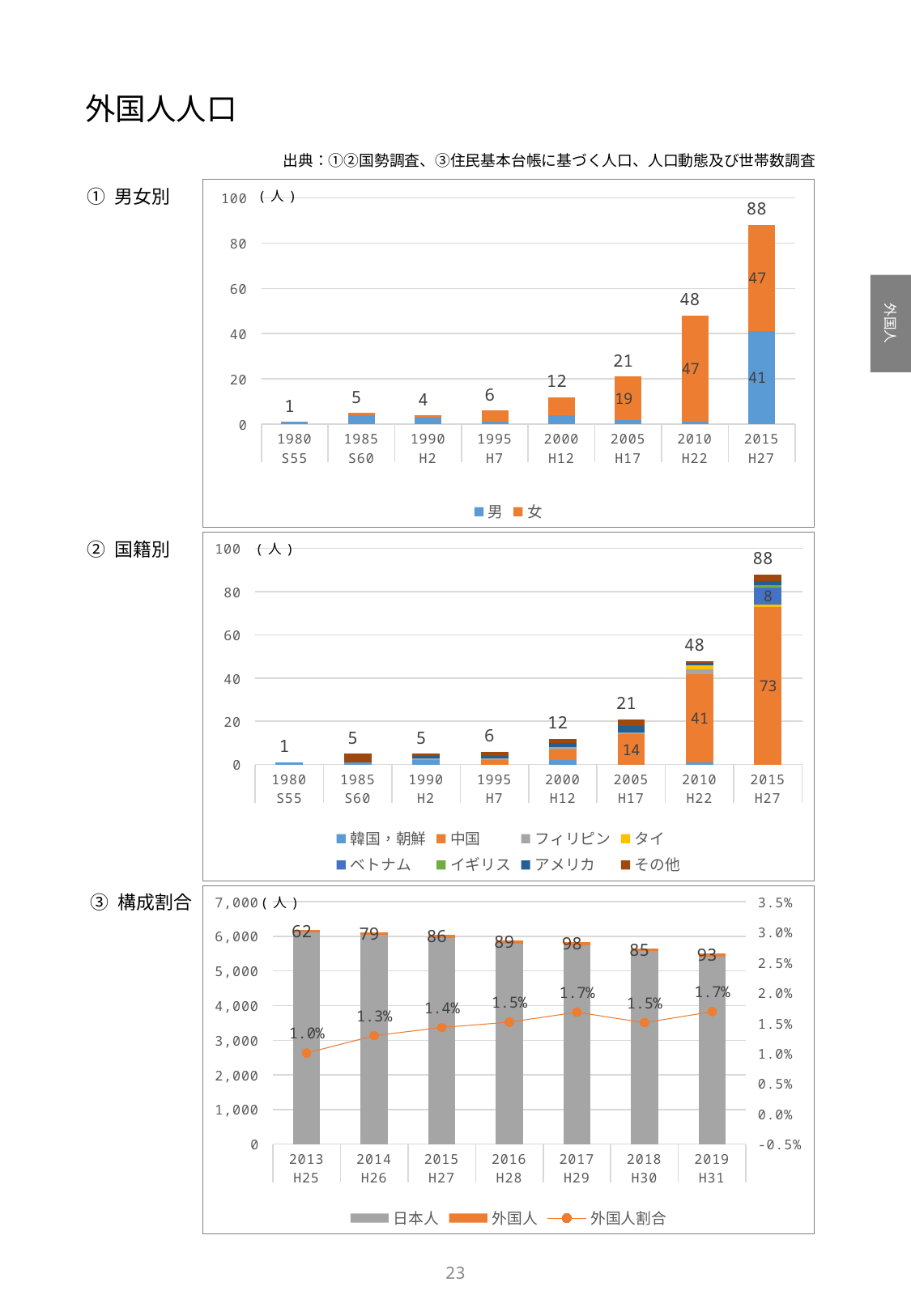
In the ① 男女別 chart, which year has the highest total? 2015 (H27) In the ① 男女別 chart, what is the total foreign population shown for 2015 (H27)? 88 In the ③ 構成割合 chart, what is the value for 外国人 in 2017 (H29)? 98 In the ① 男女別 chart, what is the value for 男 in 2015 (H27)? 41 In the ① 男女別 chart, what is the value for 女 in 2010 (H22)? 47 In the ③ 構成割合 chart, how many years are shown on the x axis? 7 In the ② 国籍別 chart, what is the value for 中国 in 2015 (H27)? 73 In the ③ 構成割合 chart, what is the 外国人割合 for 2013 (H25)? 1.0% In the ① 男女別 chart, how many series does the legend list? 2 In the ① 男女別 chart, what is the difference between the totals for 2015 and 2010? 40 In the ② 国籍別 chart, how many series does the legend list? 8 In the ② 国籍別 chart, what is the value for ベトナム in 2015 (H27)? 8